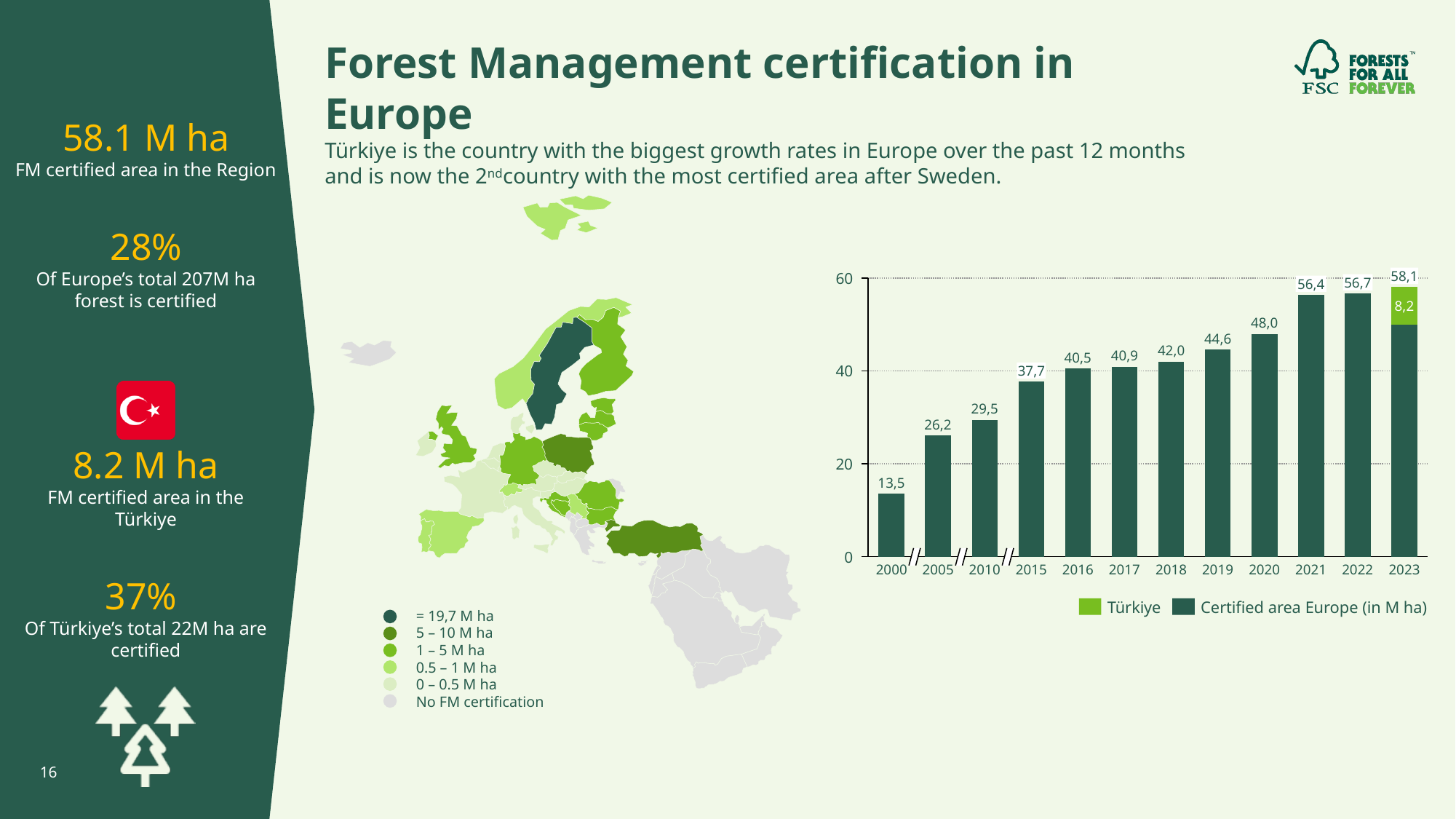
In the bar chart, what is the certified area in Europe for 2015? 37,7 In the bar chart, what value is labelled for the year 2000? 13,5 In the bar chart, what is the Türkiye value shown in the 2023 bar? 8,2 What type of chart is shown on the right side of the slide? bar chart Do the values in the bar chart rise or fall from 2000 to 2023? rise In the bar chart, which year has the lowest value? 2000 In the bar chart, what is the difference between the 2020 value and the 2019 value? 3,4 In the bar chart, which is larger: the value for 2010 or the value for 2005? 2010 In the bar chart, which year has the highest total value? 2023 How many series does the bar chart legend list? 2 How many years are shown on the x axis of the bar chart? 12 In the bar chart, is the value for 2018 greater or less than 40? greater